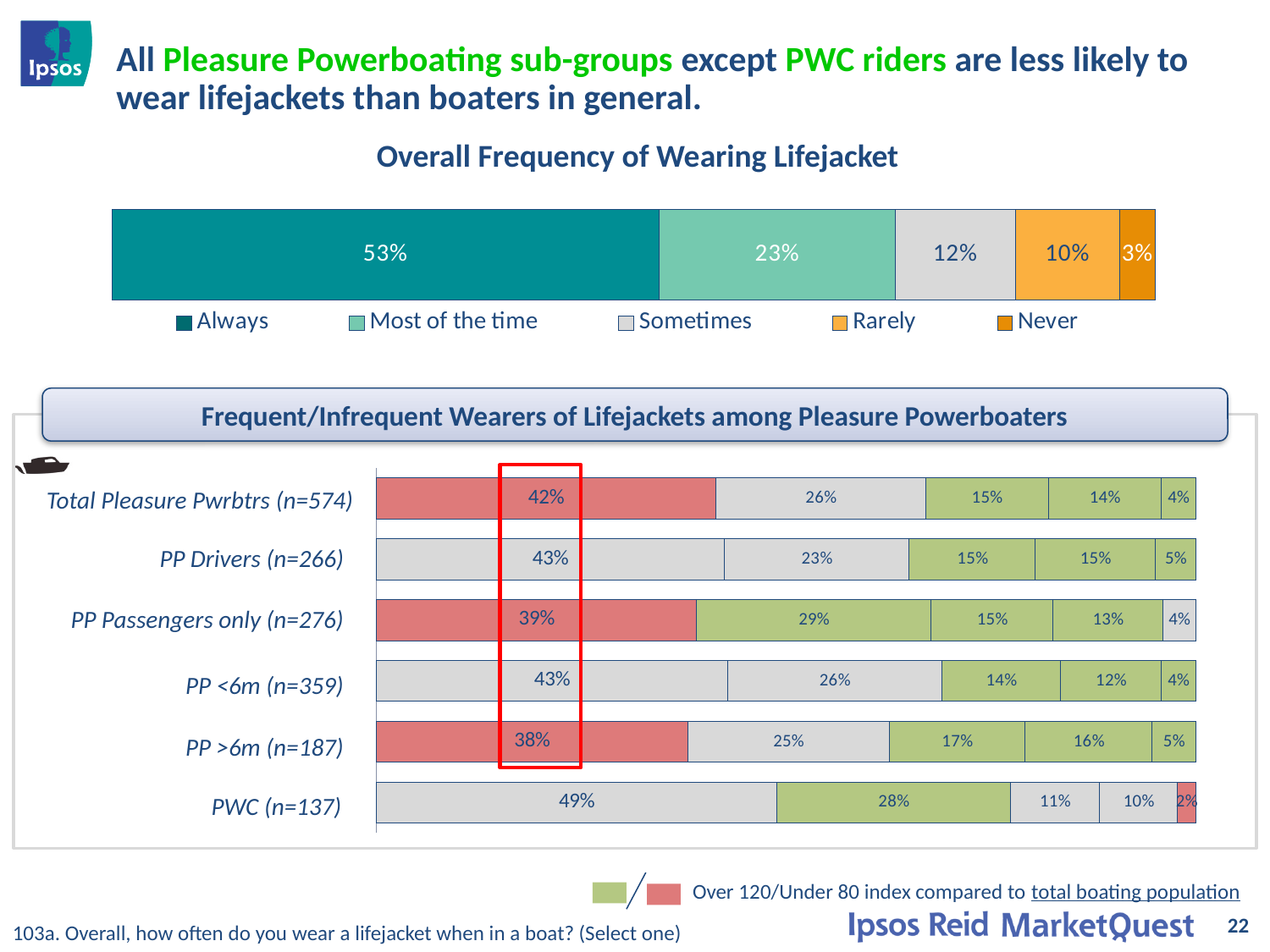
In the 'Overall Frequency of Wearing Lifejacket' chart, what percentage of boaters say they 'Always' wear a lifejacket? 53% In the 'Frequent/Infrequent Wearers of Lifejackets among Pleasure Powerboaters' chart, which sub-group has the highest leftmost segment value? PWC (n=137) In the 'Frequent/Infrequent Wearers of Lifejackets among Pleasure Powerboaters' chart, what is the first (leftmost) segment value for PWC (n=137)? 49% How many categories does the legend of the 'Overall Frequency of Wearing Lifejacket' chart list? 5 In the 'Overall Frequency of Wearing Lifejacket' chart, what is the difference between the 'Always' and 'Most of the time' percentages? 30 percentage points In the 'Overall Frequency of Wearing Lifejacket' chart, what percentage is shown for 'Never'? 3% In the 'Frequent/Infrequent Wearers of Lifejackets among Pleasure Powerboaters' chart, what is the difference between the leftmost segment values for PP Drivers (n=266) and PP >6m (n=187)? 5 percentage points In the 'Frequent/Infrequent Wearers of Lifejackets among Pleasure Powerboaters' chart, which sub-group has the lowest leftmost segment value? PP >6m (n=187) What kind of chart is the 'Overall Frequency of Wearing Lifejacket' chart? Stacked bar chart In the 'Overall Frequency of Wearing Lifejacket' chart, which is larger: 'Sometimes' or 'Rarely'? Sometimes How many sub-groups (bars) are shown in the 'Frequent/Infrequent Wearers of Lifejackets among Pleasure Powerboaters' chart? 6 In the 'Overall Frequency of Wearing Lifejacket' chart, which response has the largest share? Always